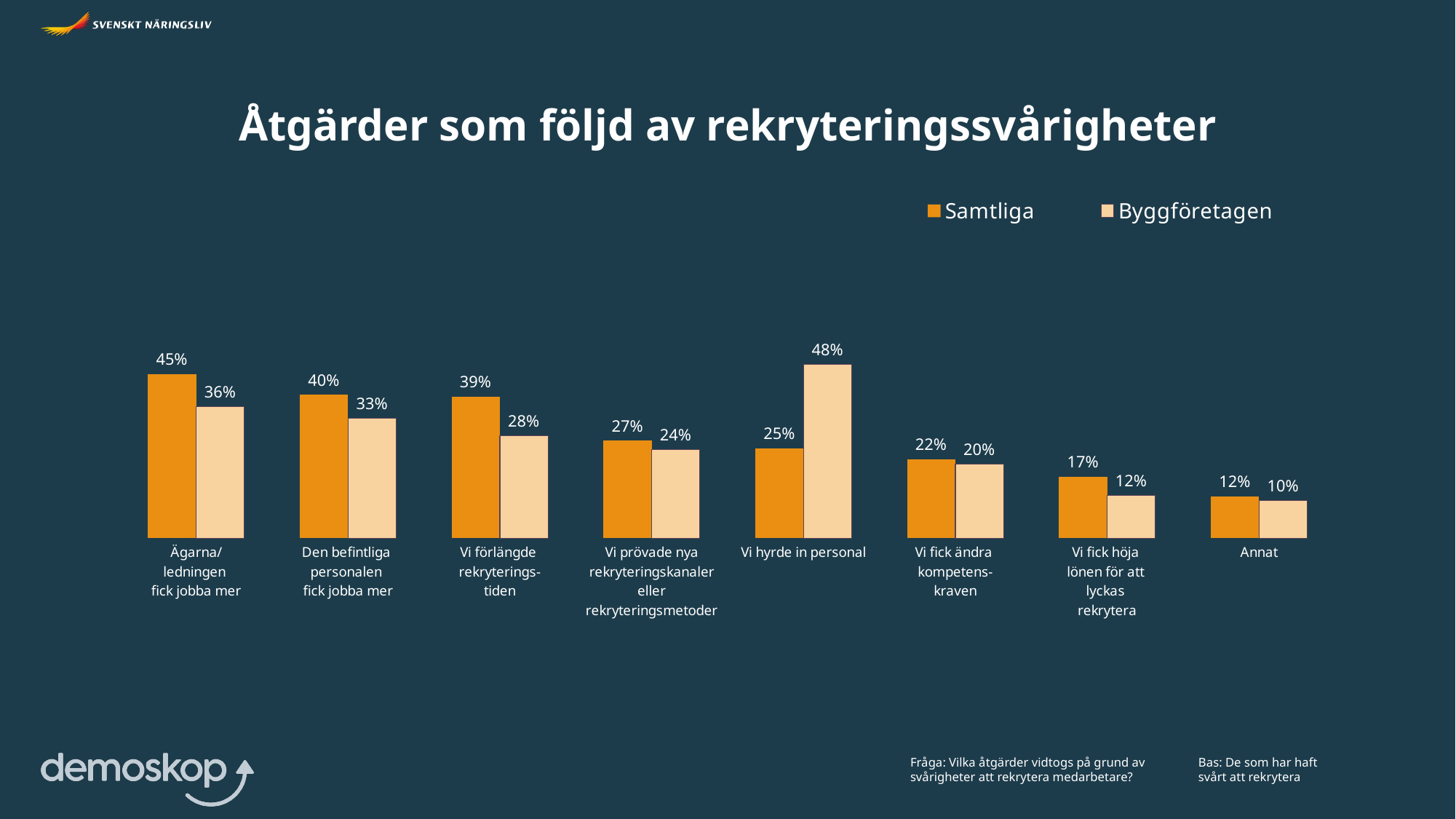
What is the Byggföretagen value for "Vi hyrde in personal"? 48% Which category has the highest Samtliga value? Ägarna/ledningen fick jobba mer What is the title of the chart? Åtgärder som följd av rekryteringssvårigheter What is the Byggföretagen value for "Annat"? 10% What is the Samtliga value for "Ägarna/ledningen fick jobba mer"? 45% What kind of chart is shown on the slide? Bar chart What is the difference between the Byggföretagen and Samtliga values for "Vi hyrde in personal"? 23% Which is larger for "Vi förlängde rekryteringstiden": the Samtliga value or the Byggföretagen value? Samtliga Which category has the lowest Byggföretagen value? Annat How many categories are shown on the x axis? 8 How many series does the legend list? 2 What is the Samtliga value for "Vi hyrde in personal"? 25%